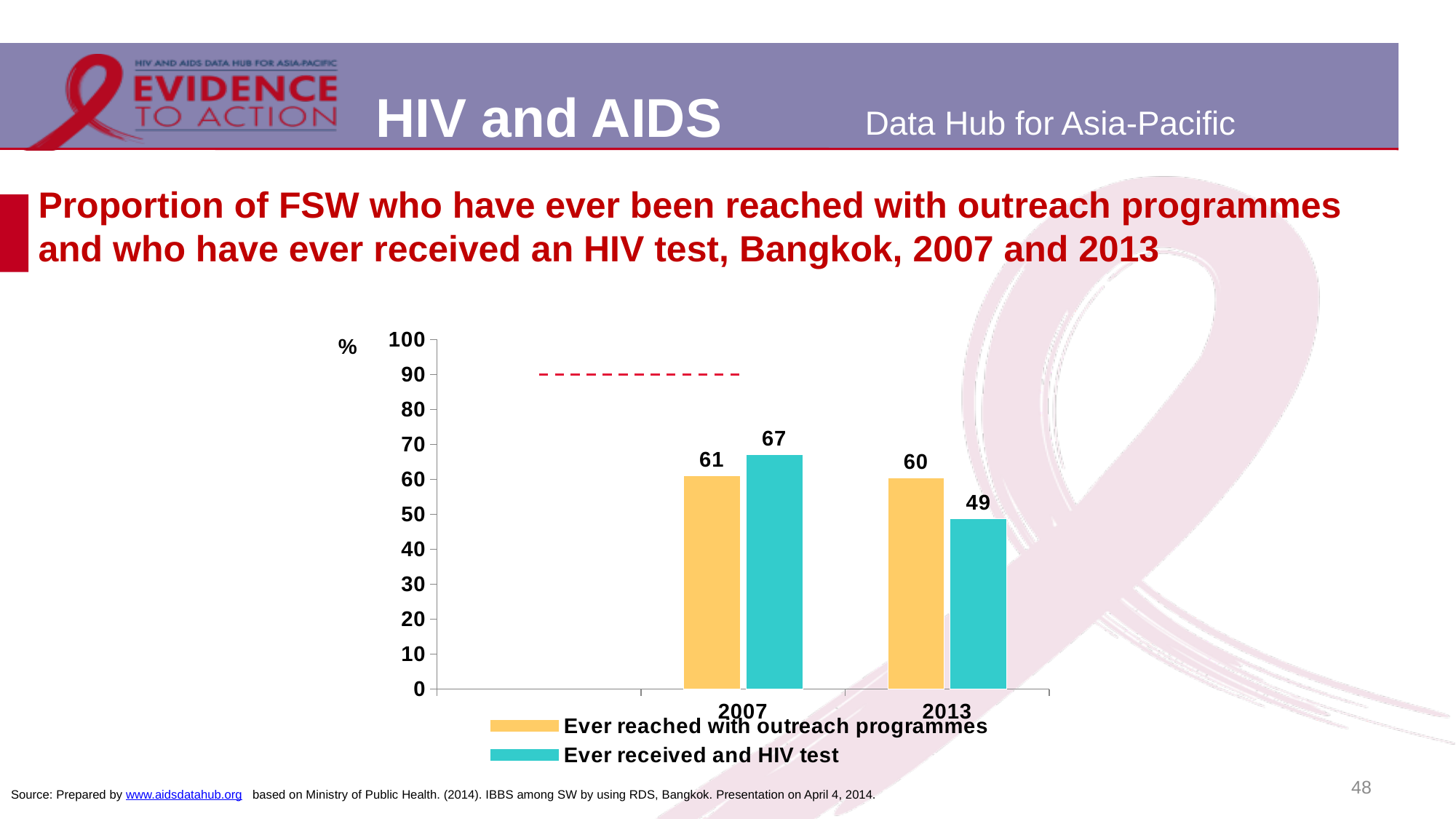
What is the value for 'Ever received and HIV test' in 2007? 67 What is the value for 'Ever received and HIV test' in 2013? 49 Which bar has the lowest value on the chart? Ever received and HIV test, 2013 What is the value for 'Ever reached with outreach programmes' in 2007? 61 Which bar has the highest value on the chart? Ever received and HIV test, 2007 Does the value for 'Ever received and HIV test' rise or fall from 2007 to 2013? Fall How many series does the legend list? 2 What kind of chart is shown on the slide? Bar chart How many years are shown on the x axis? 2 What is the difference between the 'Ever received and HIV test' values for 2007 and 2013? 18 In 2013, which is larger: 'Ever reached with outreach programmes' or 'Ever received and HIV test'? Ever reached with outreach programmes What is the value for 'Ever reached with outreach programmes' in 2013? 60